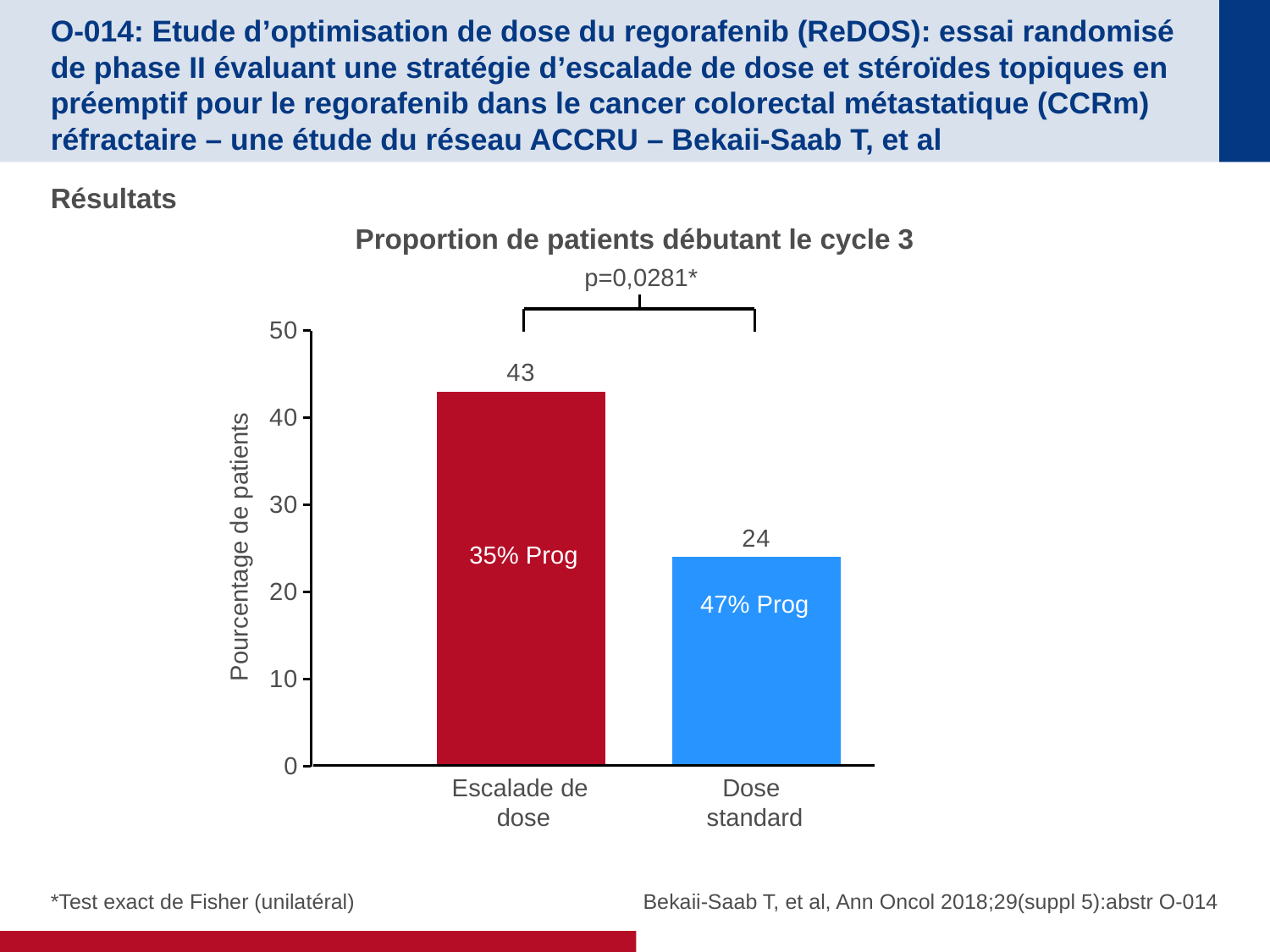
Which category has the lowest value? Dose standard What is the difference between the values for Escalade de dose and Dose standard? 19 What p-value is shown above the bars? p=0,0281* How many categories are shown on the x axis? 2 What kind of chart is shown? bar chart Is the value for Escalade de dose greater or less than 40? greater What is the value for Dose standard? 24 Which category has the highest value? Escalade de dose What is the title of the chart? Proportion de patients débutant le cycle 3 Is the value for Dose standard greater or less than 30? less Which is larger, the value for Escalade de dose or the value for Dose standard? Escalade de dose What is the value for Escalade de dose? 43